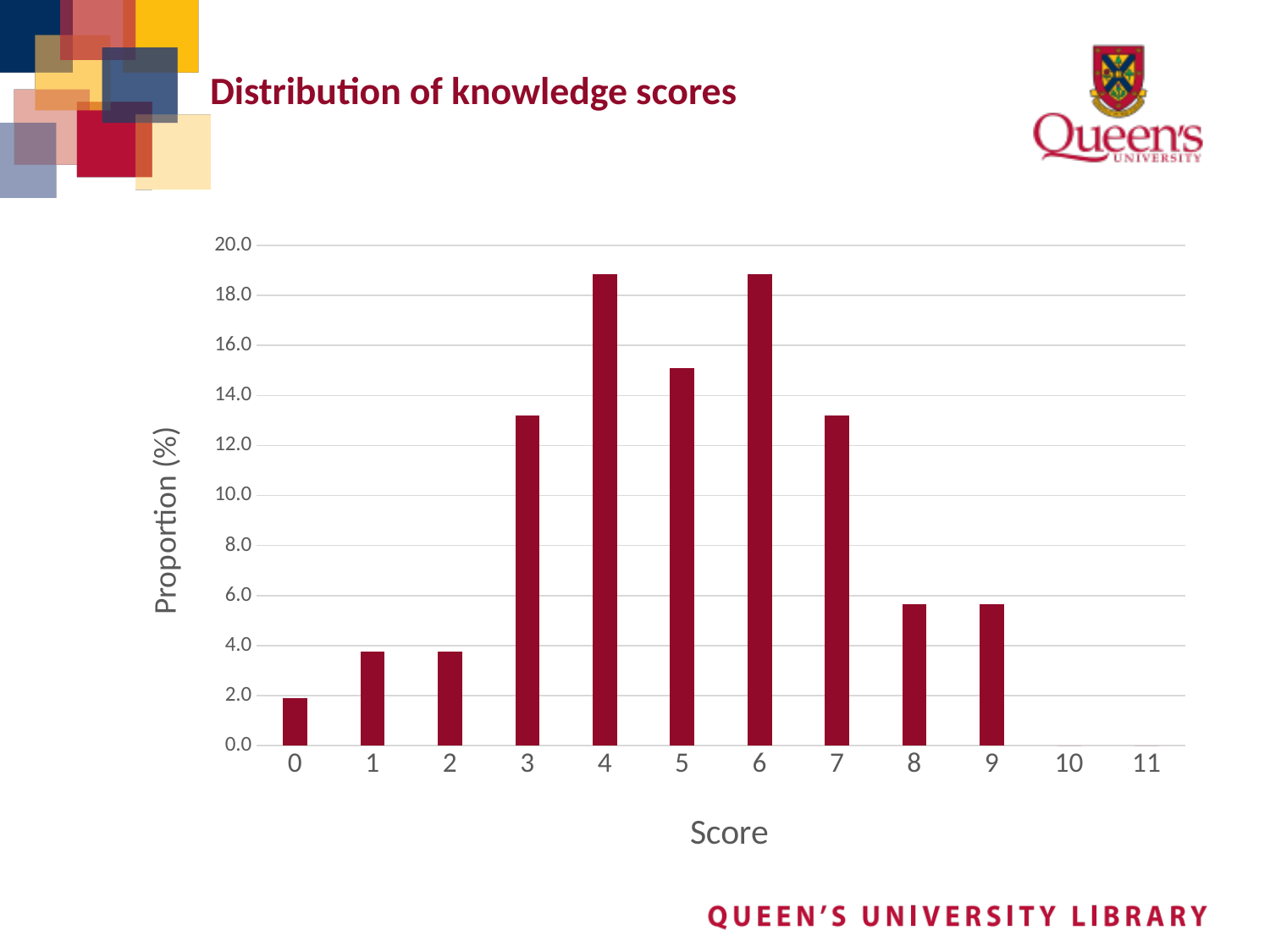
How many score categories are labelled on the x axis? 12 What is the title of the chart? Distribution of knowledge scores Which has the larger proportion, score 4 or score 8? score 4 What kind of chart is shown on the slide? bar chart Is the value for score 0 greater or less than 4.0? less Is the value for score 4 greater or less than 18.0? greater Do the values rise or fall from score 6 to score 9? fall Is the value for score 5 greater or less than 14.0? greater Which has the larger proportion, score 5 or score 3? score 5 What is the label of the vertical axis? Proportion (%)